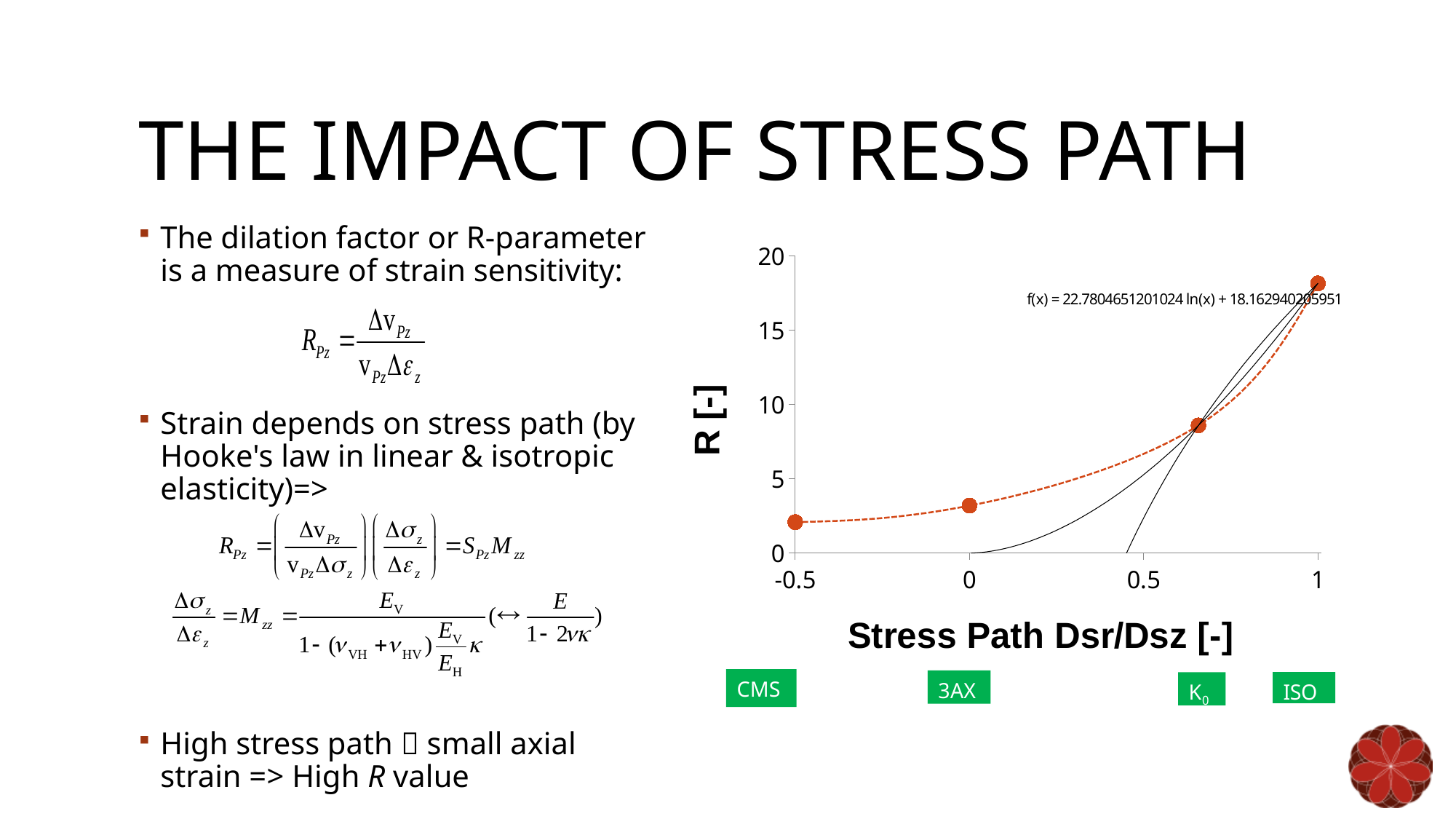
Is the R value at a stress path of 1 greater or less than 15? greater Is the R value at a stress path of 1 greater or less than 20? less Is the R value at a stress path of -0.5 greater or less than 5? less What is the title of the x axis? Stress Path Dsr/Dsz [-] How many data points are plotted on the chart? 4 Do the R values rise or fall as the stress path increases along the x axis? rise What trendline equation is displayed on the chart? f(x) = 22.7804651201024 ln(x) + 18.162940205951 At which stress path value is R highest? 1 What kind of chart is shown on the slide? scatter chart Which has the larger R value: the point at stress path 0 or the point at stress path 1? the point at stress path 1